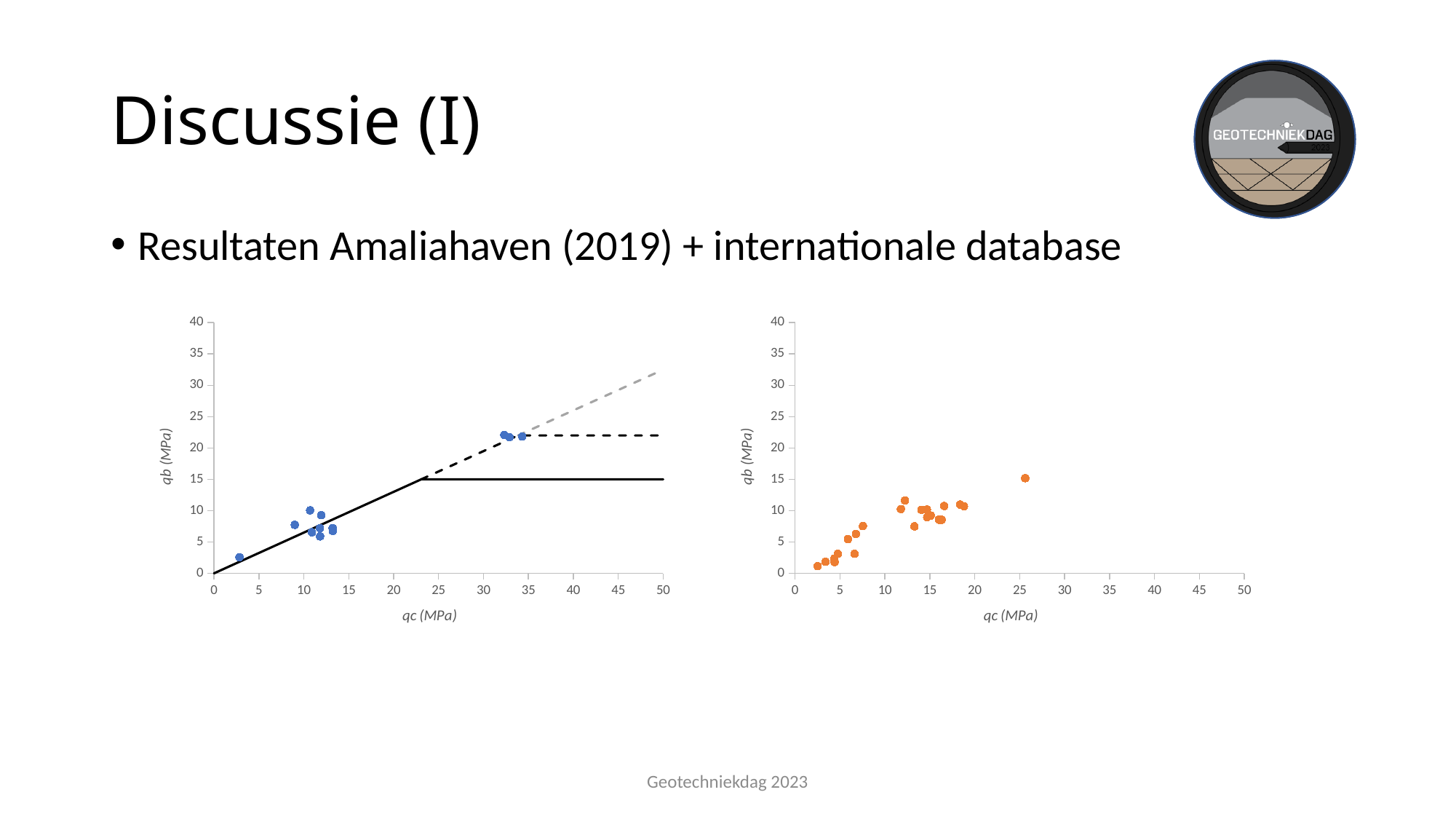
What kind of chart is the left chart on the slide? scatter chart In the left chart, at what qb (MPa) value does the solid black line level off? 15 In the left chart, do the blue points generally rise or fall as qc increases? rise What is the label of the y axis on both charts? qb (MPa) In the right chart, is the qb value of the orange point with the highest qc (around 25 MPa) greater or less than 10? greater In the left chart, is the qb value of the blue point near qc = 3 MPa greater or less than 5? less In the right chart, is the qb value of the orange point with the highest qc (around 25 MPa) greater or less than 20? less What kind of chart is the right chart on the slide? scatter chart In the right chart, do the qb values generally rise or fall as qc increases? rise What is the label of the x axis on both charts? qc (MPa)